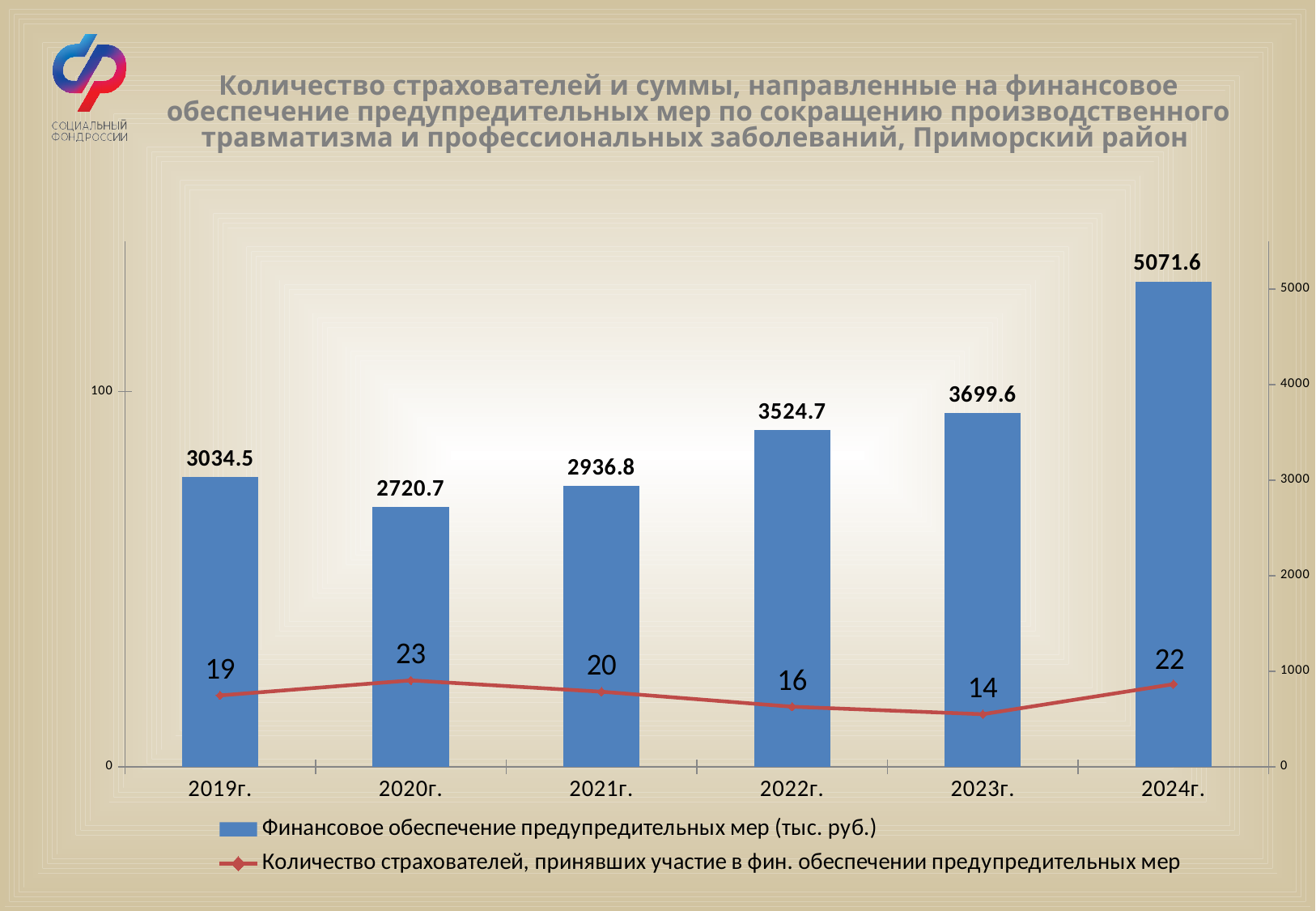
What is the difference between the bar values for 2024г. and 2023г.? 1372 Which year has the highest bar value for Финансовое обеспечение предупредительных мер? 2024г. Which is larger: the bar value for 2019г. or for 2021г.? 2019г. Which year has the lowest bar value for Финансовое обеспечение предупредительных мер? 2020г. Do the bar values rise or fall from 2022г. to 2024г.? Rise What is the value of the bar for 2020г. (Финансовое обеспечение предупредительных мер, тыс. руб.)? 2720.7 How many series does the legend list? 2 How many insurers (Количество страхователей) participated in 2023г. according to the line series? 14 What kind of chart is shown on the slide? Combined bar and line chart How many years (categories) are shown on the x axis? 6 Which year has the highest number of insurers (Количество страхователей) on the line series? 2020г. What colour are the bars for Финансовое обеспечение предупредительных мер? Blue